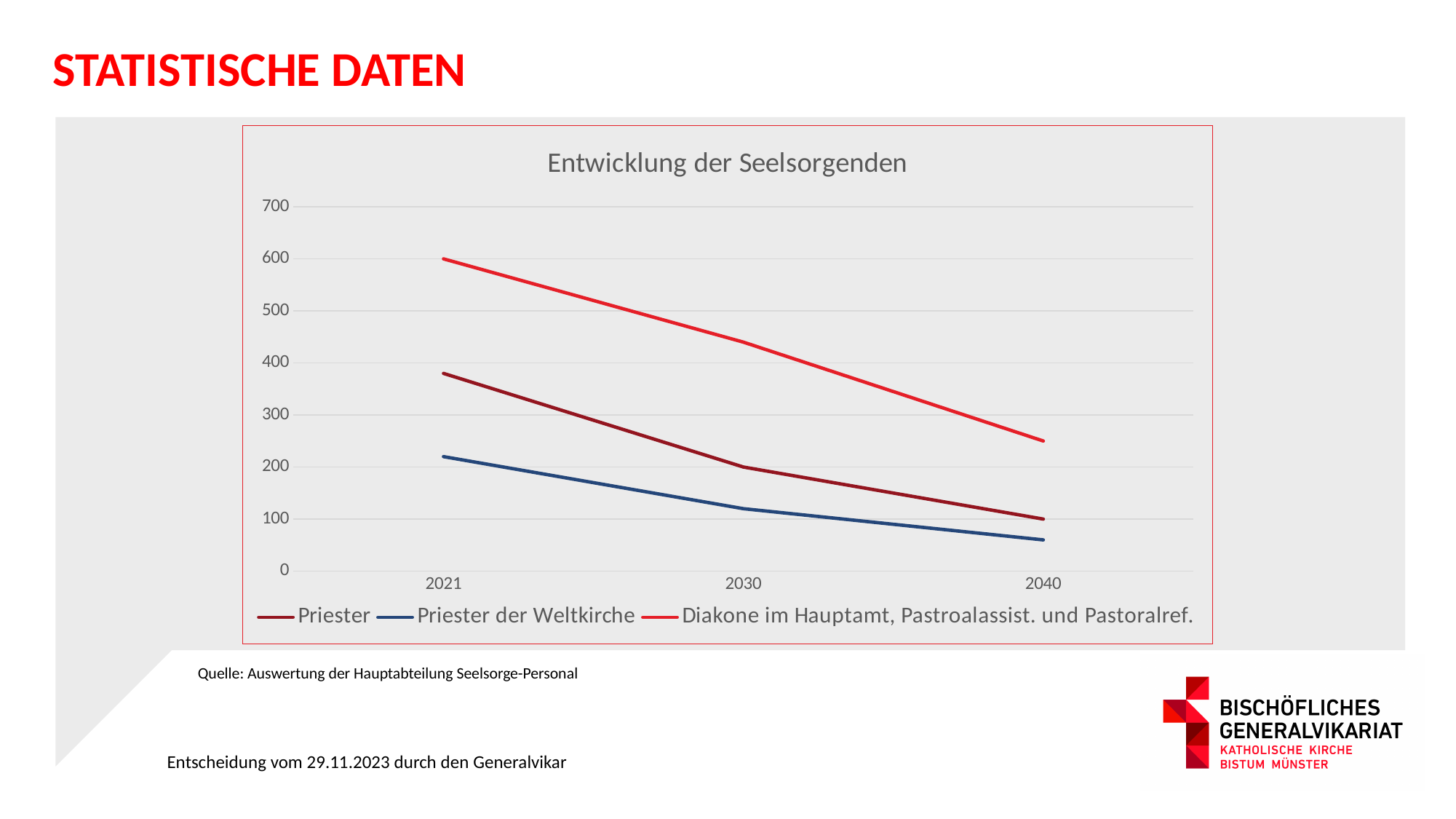
Is the value for Priester in 2021 greater or less than 300? greater How many points are shown on the x axis? 3 What is the title of the chart? Entwicklung der Seelsorgenden Which series has the highest value in 2021? Diakone im Hauptamt, Pastroalassist. und Pastoralref. What kind of chart is shown on the slide? line chart Is the value for Diakone im Hauptamt, Pastroalassist. und Pastoralref. in 2040 greater or less than 300? less Do the values for Priester rise or fall from 2021 to 2040? fall Is the value for Priester der Weltkirche in 2021 greater or less than 300? less Which series has the lowest value in 2040? Priester der Weltkirche Which is larger in 2030: the value for Priester or the value for Priester der Weltkirche? Priester How many series does the legend list? 3